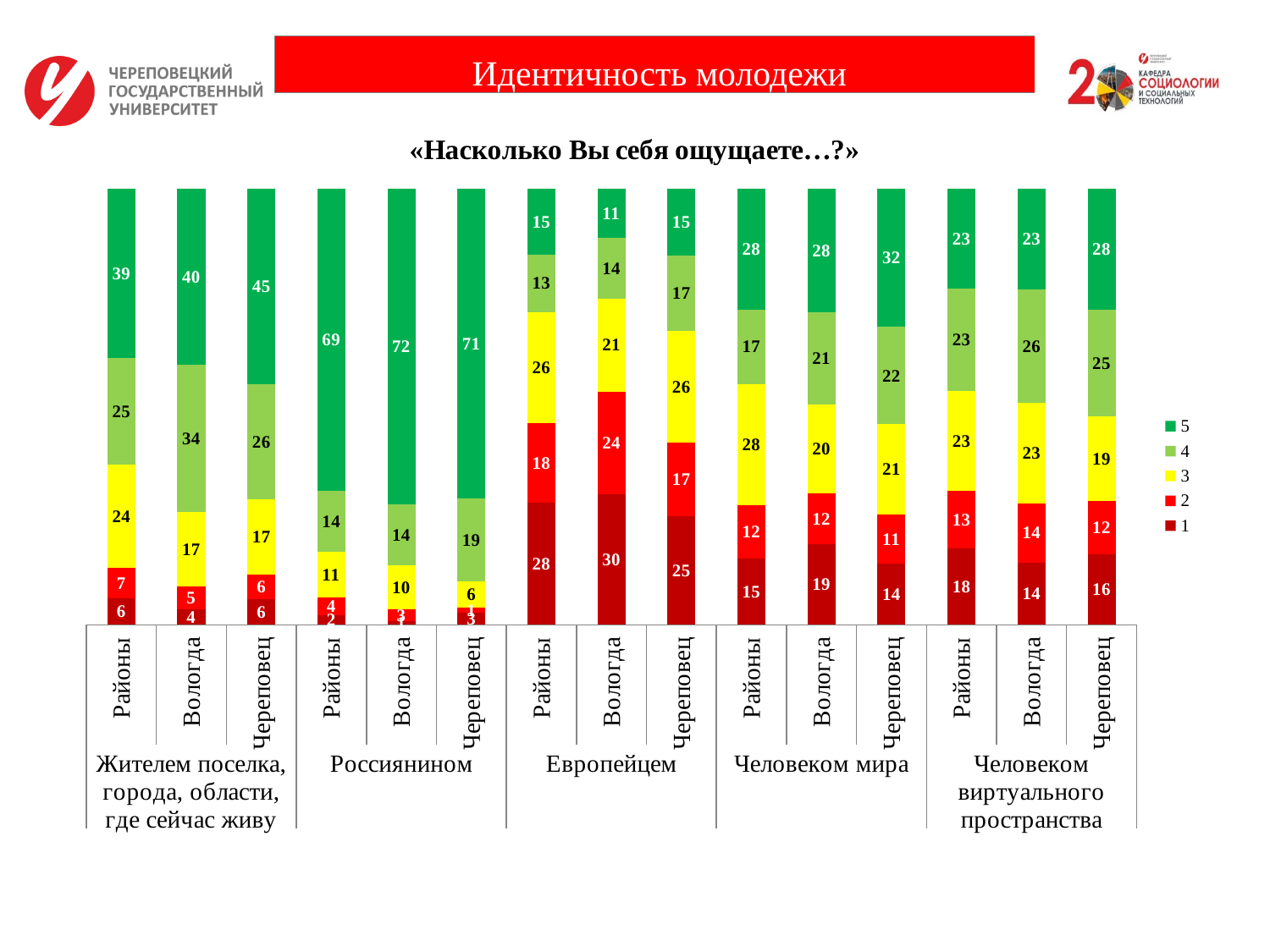
Within the «Европейцем» group, which region has the lowest value for series 5? Вологда What is the value of series 5 for Вологда in the «Россиянином» group? 72 In the «Жителем поселка, города, области, где сейчас живу» group, is the series 4 value larger for Вологда or for Череповец? Вологда What is the value of series 1 for Вологда in the «Европейцем» group? 30 How many bars are plotted in the chart? 15 What is the title of the chart? «Насколько Вы себя ощущаете…?» What is the value of series 4 for Череповец in the «Человеком виртуального пространства» group? 25 What is the value of series 3 for Районы in the «Человеком мира» group? 28 What kind of chart is shown on the slide? Stacked bar chart How many series does the legend list? 5 What is the difference between the series 5 values for Череповец and Районы in the «Человеком мира» group? 4 Within the «Жителем поселка, города, области, где сейчас живу» group, which region has the highest value for series 5? Череповец